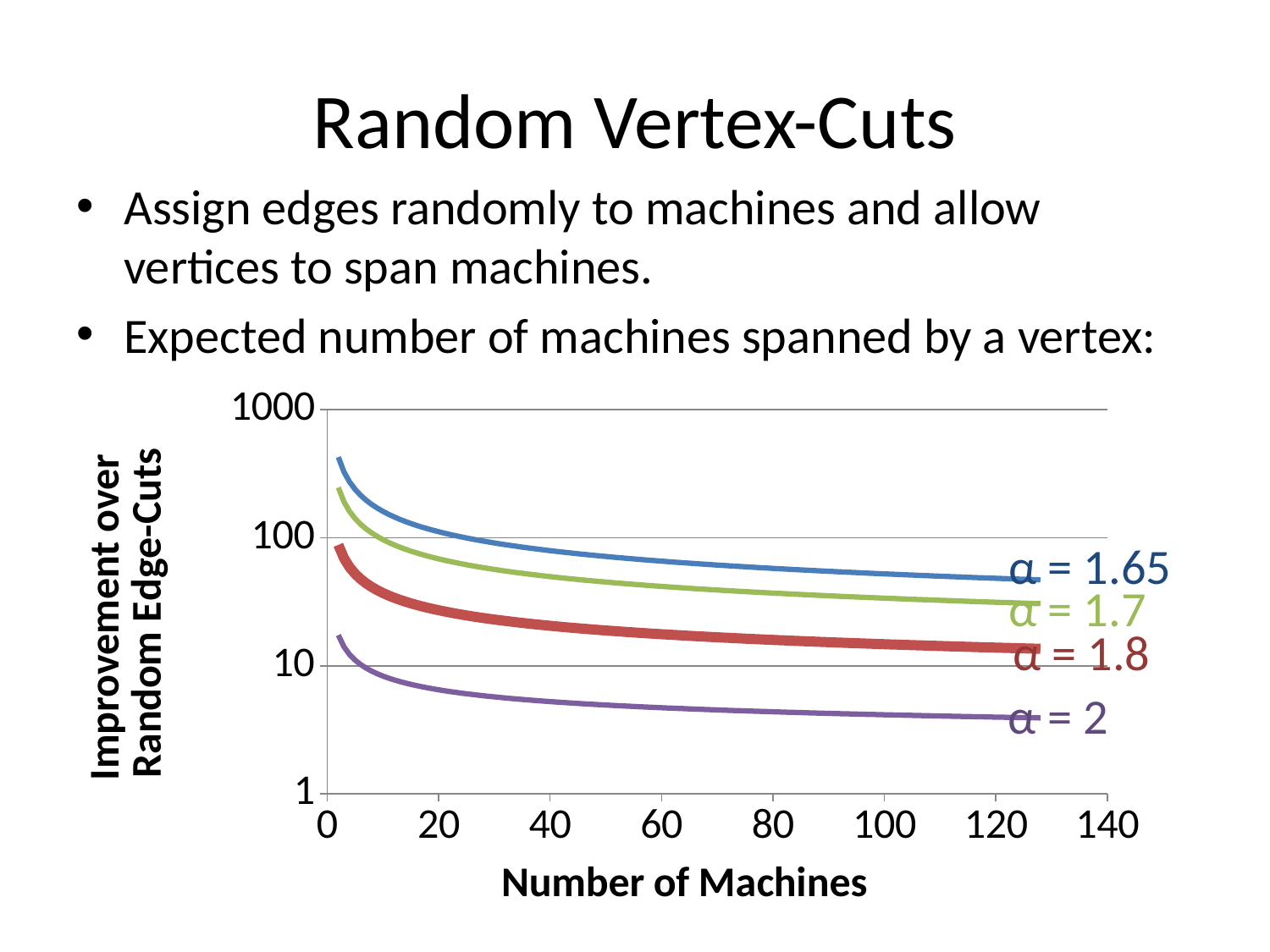
What is the title of the x axis? Number of Machines Which series has the highest improvement over random edge-cuts across the number of machines? α = 1.65 How many series (α values) are plotted on the chart? 4 Do the values rise or fall as the number of machines increases? fall Is the value for α = 1.8 at 120 machines greater or less than 100? less Is the value for α = 2 at 120 machines greater or less than 10? less What is the title of the y axis? Improvement over Random Edge-Cuts Which series has the lowest improvement over random edge-cuts across the number of machines? α = 2 What kind of chart is shown on the slide? line chart Is the value for α = 1.65 at 120 machines greater or less than 10? greater Which series has the larger value at 60 machines, α = 1.7 or α = 1.8? α = 1.7